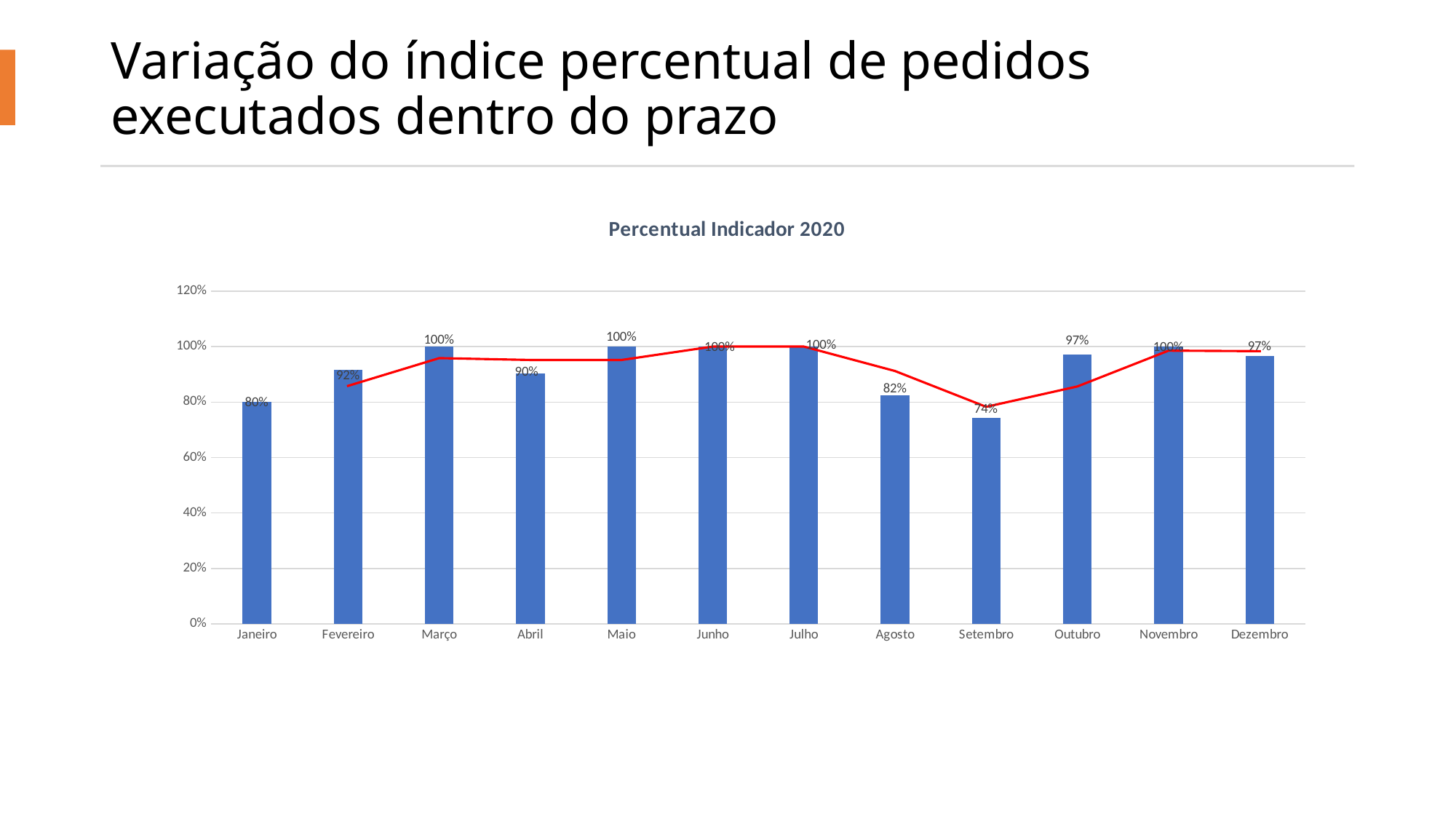
What is the title of the chart? Percentual Indicador 2020 Is the value for Setembro greater or less than 80%? less What is the value for Agosto? 82% What is the value for Janeiro? 80% Which month has the lowest value? Setembro How many months are shown on the x axis? 12 What is the value for Setembro? 74% Which is larger, the value for Fevereiro or the value for Abril? Fevereiro What is the difference between the values for Outubro and Setembro? 23% What is the value for Outubro? 97% What is the difference between the values for Março and Janeiro? 20% What kind of chart is shown on the slide? bar chart